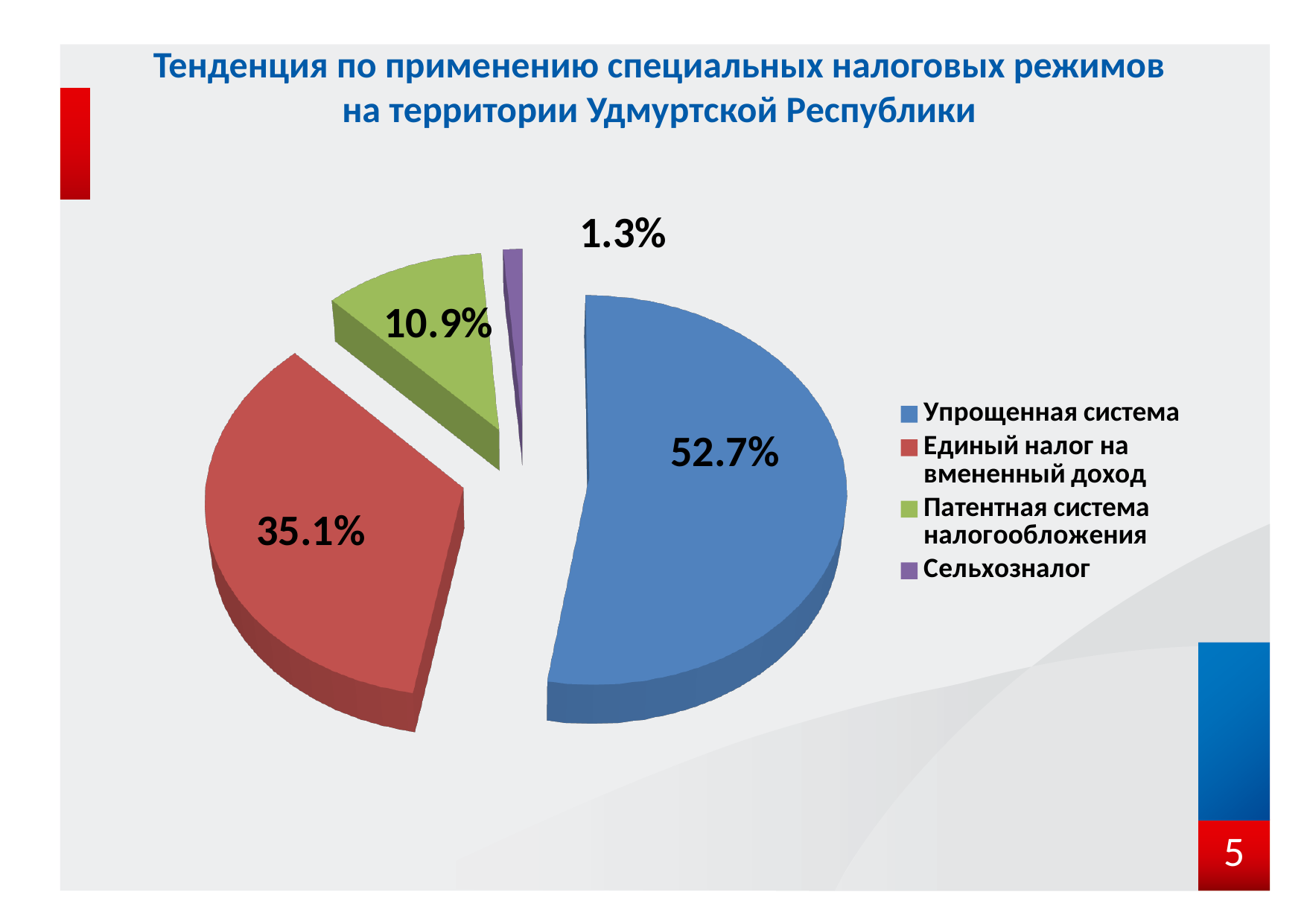
What is the difference between the shares of Упрощенная система and Единый налог на вмененный доход? 17.6% Which is larger: the share of Патентная система налогообложения or the share of Сельхозналог? Патентная система налогообложения What share of the pie does Упрощенная система have? 52.7% Which category has the smallest slice of the pie? Сельхозналог What is the value shown for Патентная система налогообложения? 10.9% What is the value shown for Единый налог на вмененный доход? 35.1% What colour is the slice for Единый налог на вмененный доход? Red What kind of chart is shown on the slide? Pie chart What is the difference between the shares of Патентная система налогообложения and Сельхозналог? 9.6% How many categories does the pie chart show? 4 What is the value shown for Сельхозналог? 1.3% Which category has the largest slice of the pie? Упрощенная система